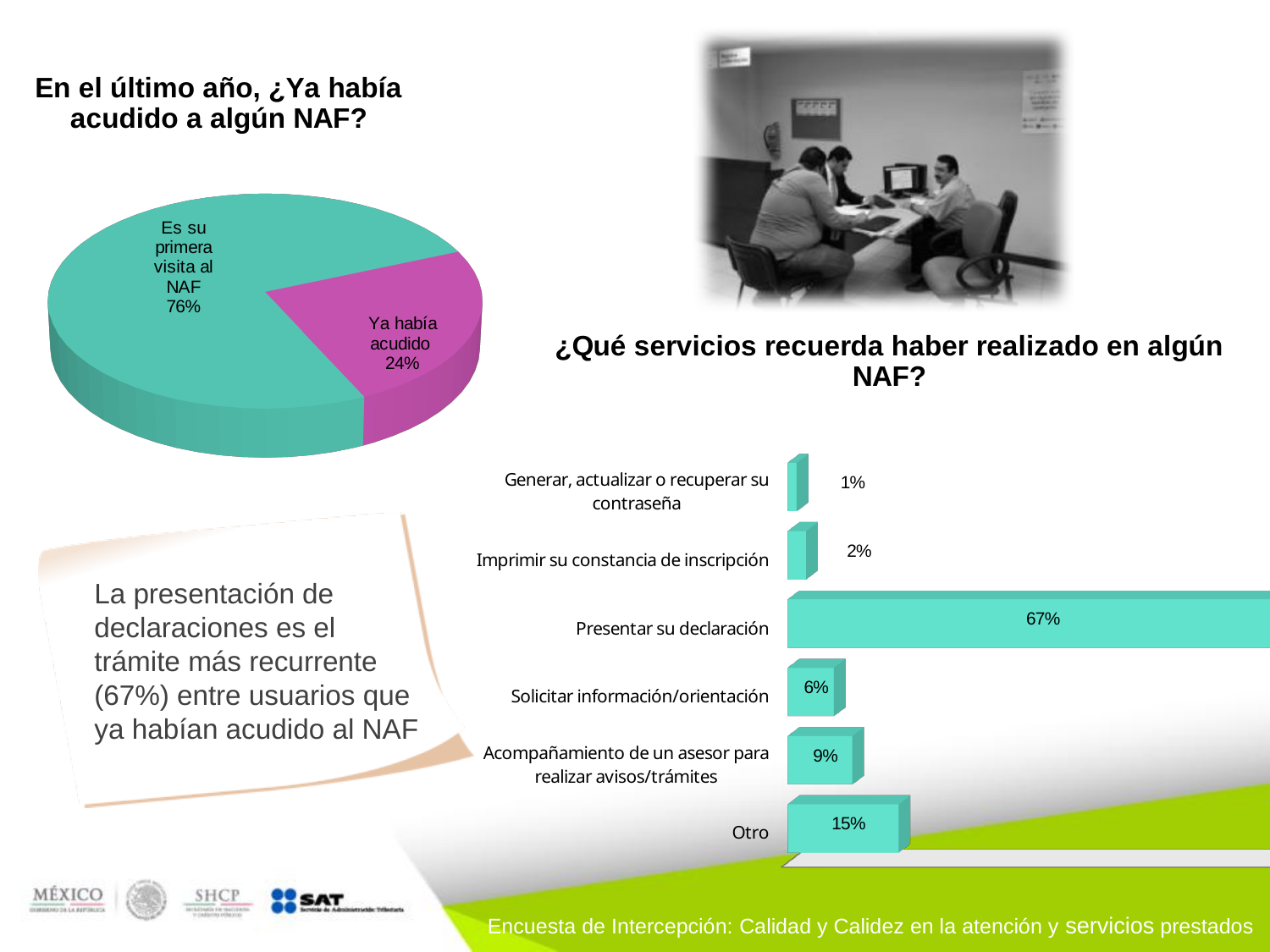
In the bar chart '¿Qué servicios recuerda haber realizado en algún NAF?', what is the difference between 'Otro' and 'Solicitar información/orientación'? 9% In the pie chart 'En el último año, ¿Ya había acudido a algún NAF?', what share is labelled 'Es su primera visita al NAF'? 76% In the bar chart '¿Qué servicios recuerda haber realizado en algún NAF?', which category has the lowest value? Generar, actualizar o recuperar su contraseña In the pie chart 'En el último año, ¿Ya había acudido a algún NAF?', which slice is larger: 'Es su primera visita al NAF' or 'Ya había acudido'? Es su primera visita al NAF What kind of chart is the one titled 'En el último año, ¿Ya había acudido a algún NAF?'? Pie chart In the pie chart 'En el último año, ¿Ya había acudido a algún NAF?', how many slices are there? 2 What kind of chart is the one titled '¿Qué servicios recuerda haber realizado en algún NAF?'? Bar chart In the bar chart '¿Qué servicios recuerda haber realizado en algún NAF?', what is the value for 'Presentar su declaración'? 67% In the pie chart 'En el último año, ¿Ya había acudido a algún NAF?', what share is labelled 'Ya había acudido'? 24% In the bar chart '¿Qué servicios recuerda haber realizado en algún NAF?', what is the value for 'Acompañamiento de un asesor para realizar avisos/trámites'? 9% In the bar chart '¿Qué servicios recuerda haber realizado en algún NAF?', how many categories are shown? 6 In the bar chart '¿Qué servicios recuerda haber realizado en algún NAF?', which category has the highest value? Presentar su declaración